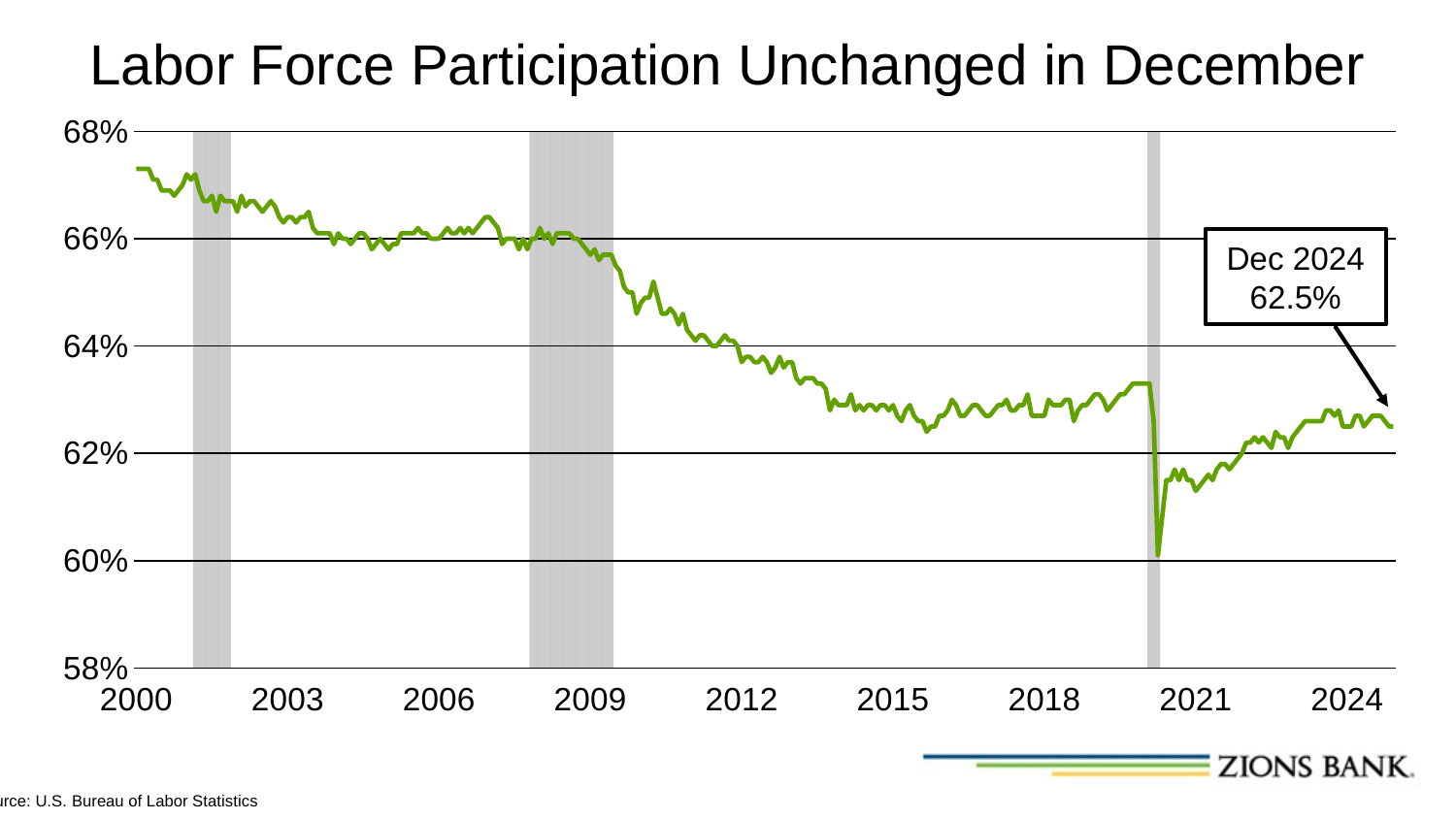
Do the values rise or fall along the x axis from 2000 to 2015? fall Is the value in 2015 greater or less than 64%? less Is the lowest point of the line, around 2020, greater or less than 62%? less What is the labor force participation rate shown for Dec 2024? 62.5% Is the value at the start of 2000 greater or less than 66%? greater What is the title of the chart? Labor Force Participation Unchanged in December What kind of chart is shown on the slide? line chart Which is larger, the value in 2012 or the value in 2021? 2012 Which is larger, the value in 2000 or the value in Dec 2024? 2000 What colour is the plotted line? green How many year labels are shown on the x axis? 9